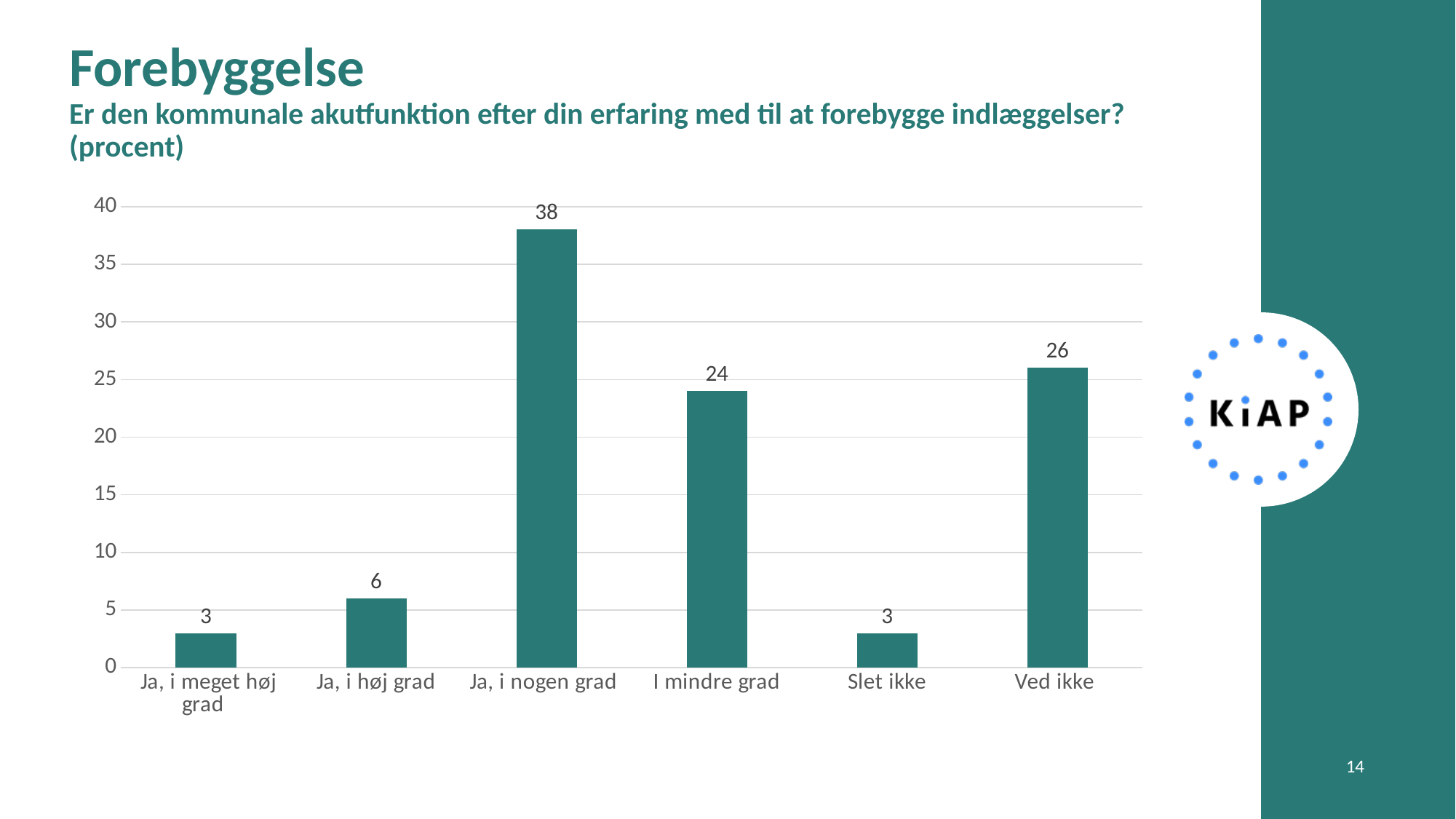
What is the value for "I mindre grad"? 24 Which category has the highest value? Ja, i nogen grad What is the value for "Ja, i høj grad"? 6 What is the title of the slide? Forebyggelse What is the value for "Ved ikke"? 26 How many categories are shown on the x axis? 6 What is the difference between the values for "Ved ikke" and "Ja, i høj grad"? 20 What is the difference between the values for "Ja, i nogen grad" and "I mindre grad"? 14 Which is larger, the value for "Ved ikke" or the value for "I mindre grad"? Ved ikke Is the value for "Ja, i nogen grad" greater or less than 35? greater What is the value for "Ja, i nogen grad"? 38 What kind of chart is shown on the slide? Bar chart